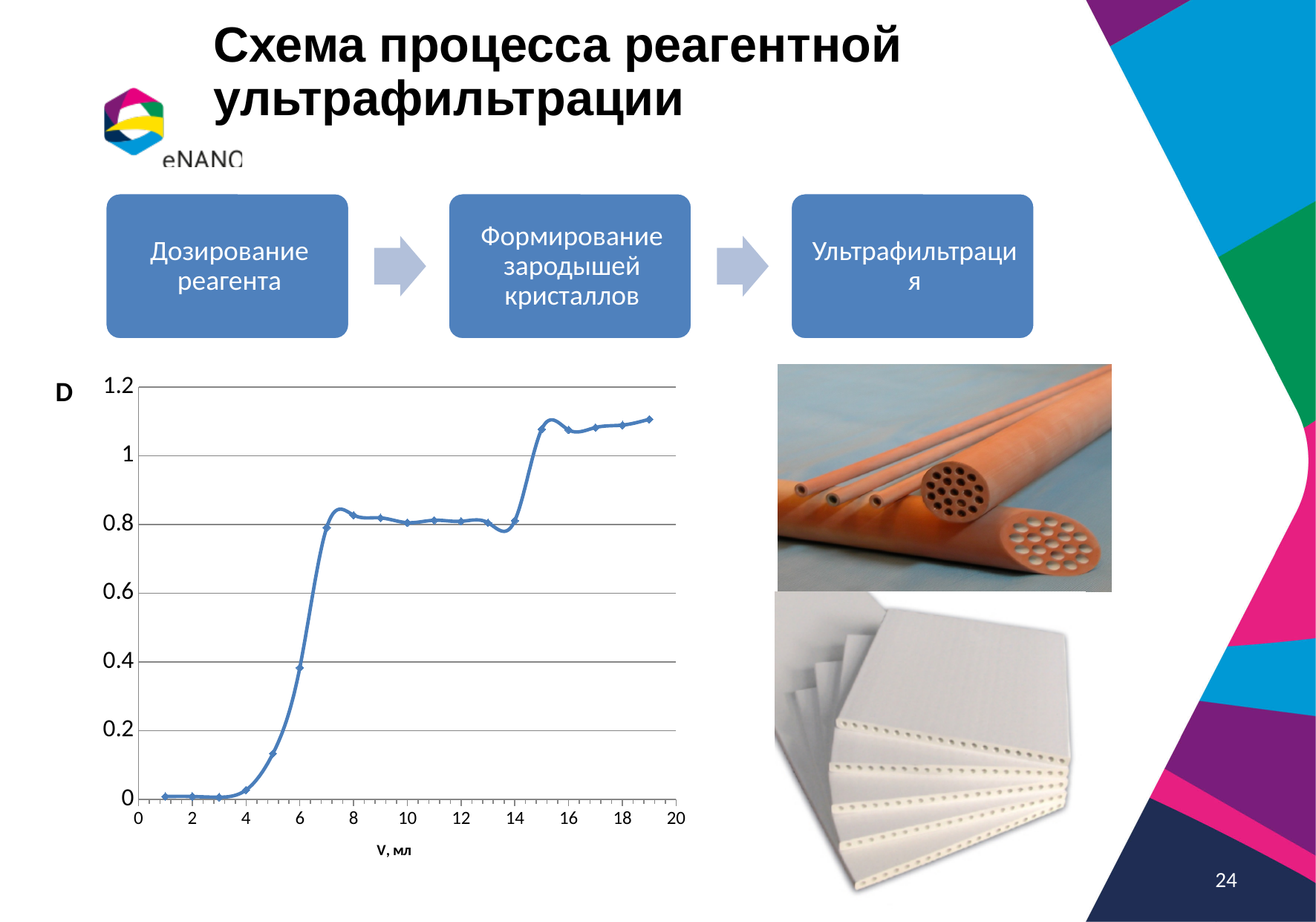
What is the label of the x axis of the chart? V, мл Is the value of D at V = 13 greater or less than 1? less Which has the larger value of D: V = 5 or V = 8? V = 8 Is the value of D at V = 10 greater or less than 0.6? greater What kind of chart is shown on the slide? line chart Which has the larger value of D: V = 10 or V = 16? V = 16 Is the value of D at V = 15 greater or less than 1? greater How many data points are plotted on the line? 19 What is the label of the y axis of the chart? D Overall, does the value of D rise or fall as V increases along the x axis? rise